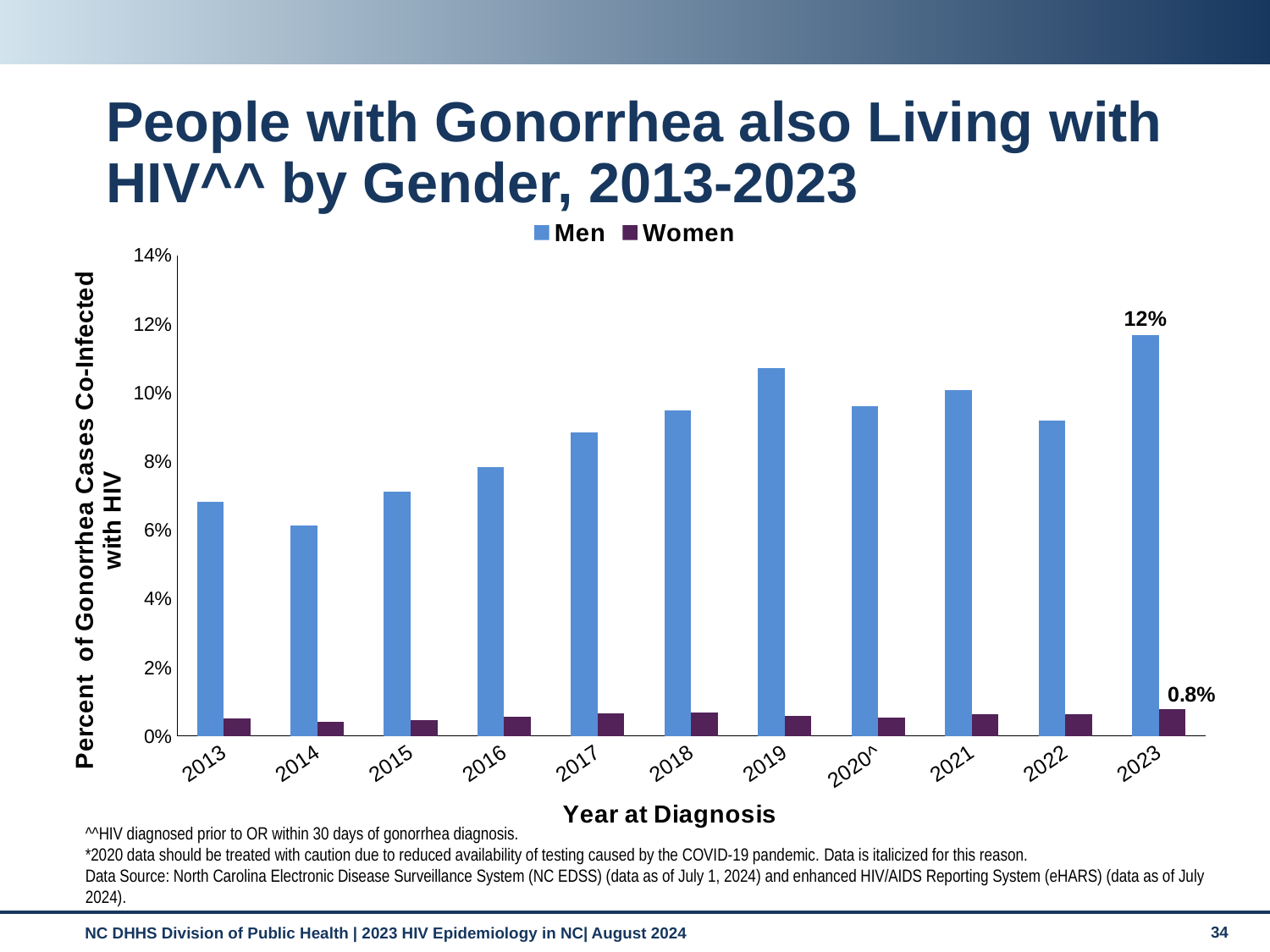
Is the value for Men in 2014 greater or less than 8%? less In which year is the value for Men the highest? 2023 What kind of chart is shown on the slide? bar chart In which year is the value for Men the lowest? 2014 How many series does the legend list? 2 How many years are shown on the x axis? 11 What is the value for Women in 2023? 0.8% What is the difference between the Men and Women values in 2023? 11.2 percentage points What is the value for Men in 2023? 12% Is the value for Men in 2019 greater or less than 10%? greater Which is larger for Men: the value in 2019 or the value in 2018? 2019 Overall, do the values for Men rise or fall from 2013 to 2023? rise